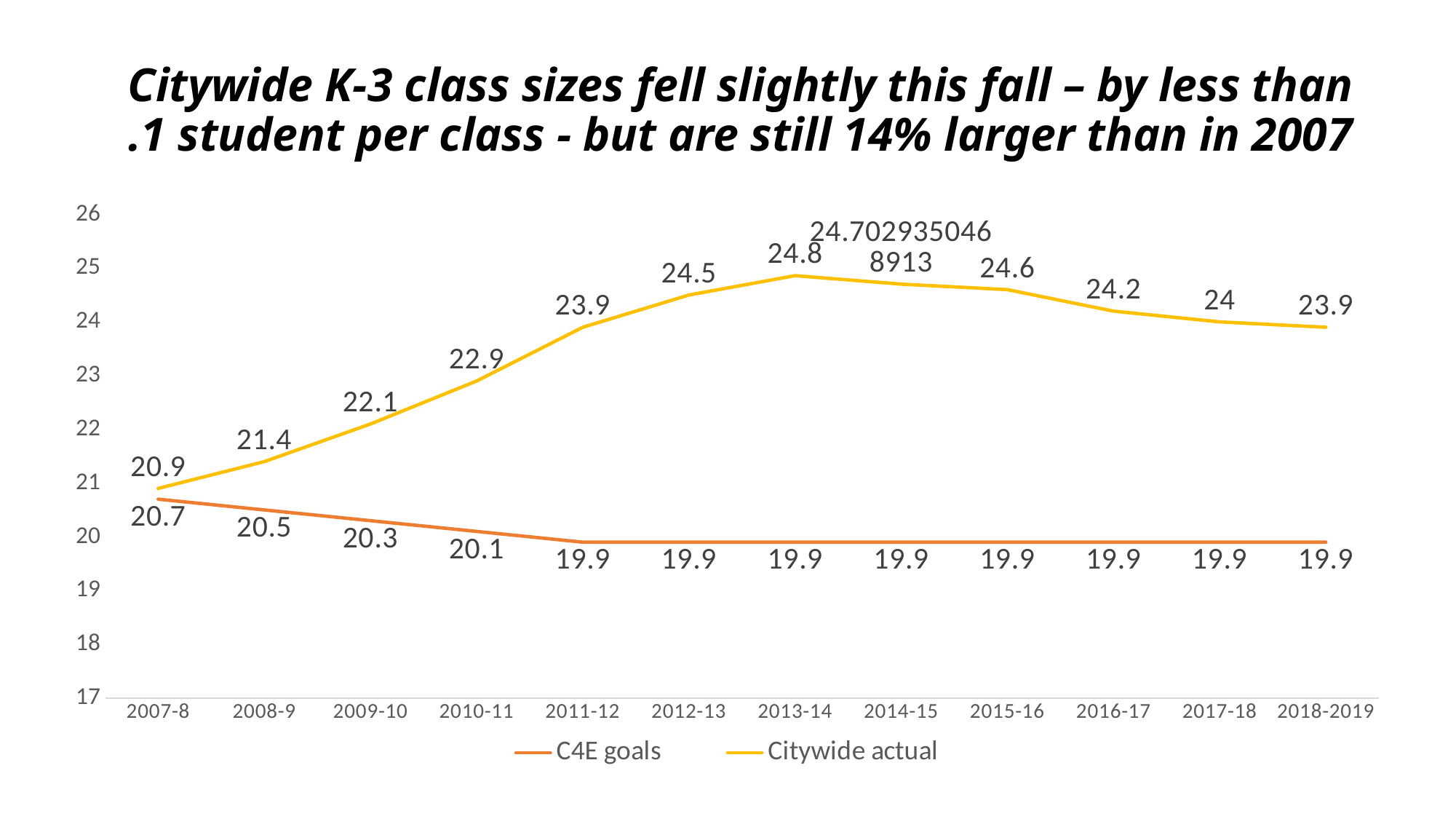
How many school years are plotted on the x axis? 12 What is the difference between the Citywide actual and C4E goals values in 2018-2019? 4 What is the Citywide actual value for 2013-14? 24.8 Do the C4E goals values rise or fall from 2007-8 to 2011-12? Fall Which is larger in 2012-13, the Citywide actual value or the C4E goals value? Citywide actual What is the Citywide actual value for 2018-2019? 23.9 In which school year is the Citywide actual value lowest? 2007-8 In which school year is the Citywide actual value highest? 2013-14 What is the difference between the Citywide actual and C4E goals values in 2007-8? 0.2 How many series does the legend list? 2 What is the C4E goals value for 2009-10? 20.3 What kind of chart is shown on the slide? Line chart